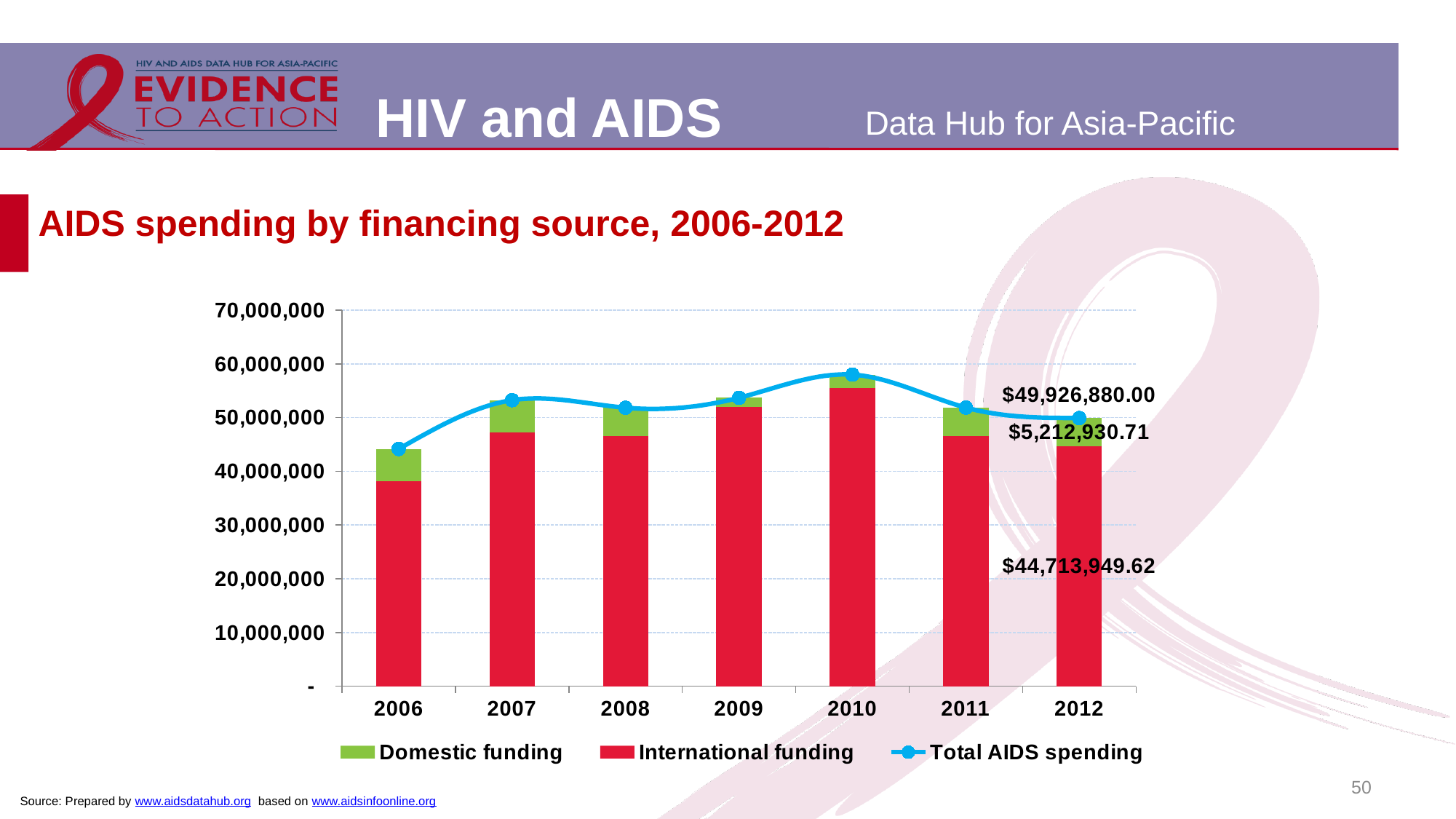
What is the Domestic funding value labelled for 2012? $5,212,930.71 What is the Total AIDS spending value labelled for 2012? $49,926,880.00 In which year is Total AIDS spending lowest? 2006 Is the International funding for 2010 greater or less than 50,000,000? greater How many series does the legend list? 3 What is the International funding value labelled for 2012? $44,713,949.62 How many years are shown on the x axis? 7 In which year is Total AIDS spending highest? 2010 Which year has the larger Total AIDS spending, 2006 or 2010? 2010 Is the Total AIDS spending for 2006 greater or less than 50,000,000? less What is the difference between International funding and Domestic funding in 2012? $39,501,018.91 Does Total AIDS spending rise or fall from 2010 to 2012? fall